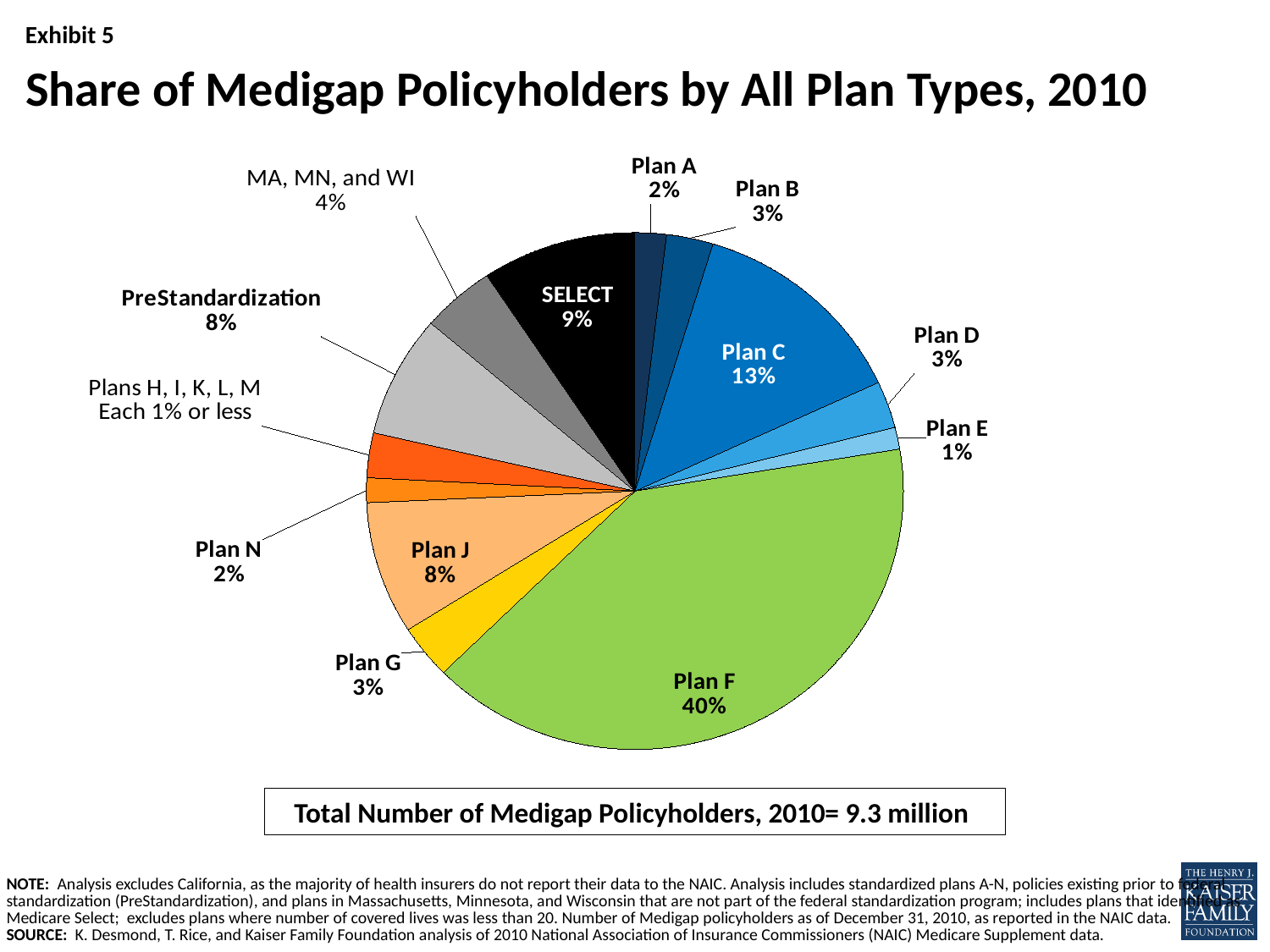
What share of Medigap policyholders had Plan C? 13% What is the difference in percentage points between Plan F and Plan C? 27 What is the total number of Medigap policyholders in 2010 stated on the slide? 9.3 million What share of Medigap policyholders had Plan F in 2010? 40% What percentage of policyholders is shown for SELECT? 9% What is the title of the chart? Share of Medigap Policyholders by All Plan Types, 2010 Which has a larger share, SELECT or MA, MN, and WI? SELECT What kind of chart is shown on the slide? Pie chart What share is shown for MA, MN, and WI? 4% Which has a larger share, Plan J or Plan G? Plan J Which plan type has the largest share of Medigap policyholders? Plan F What share is shown for PreStandardization plans? 8%